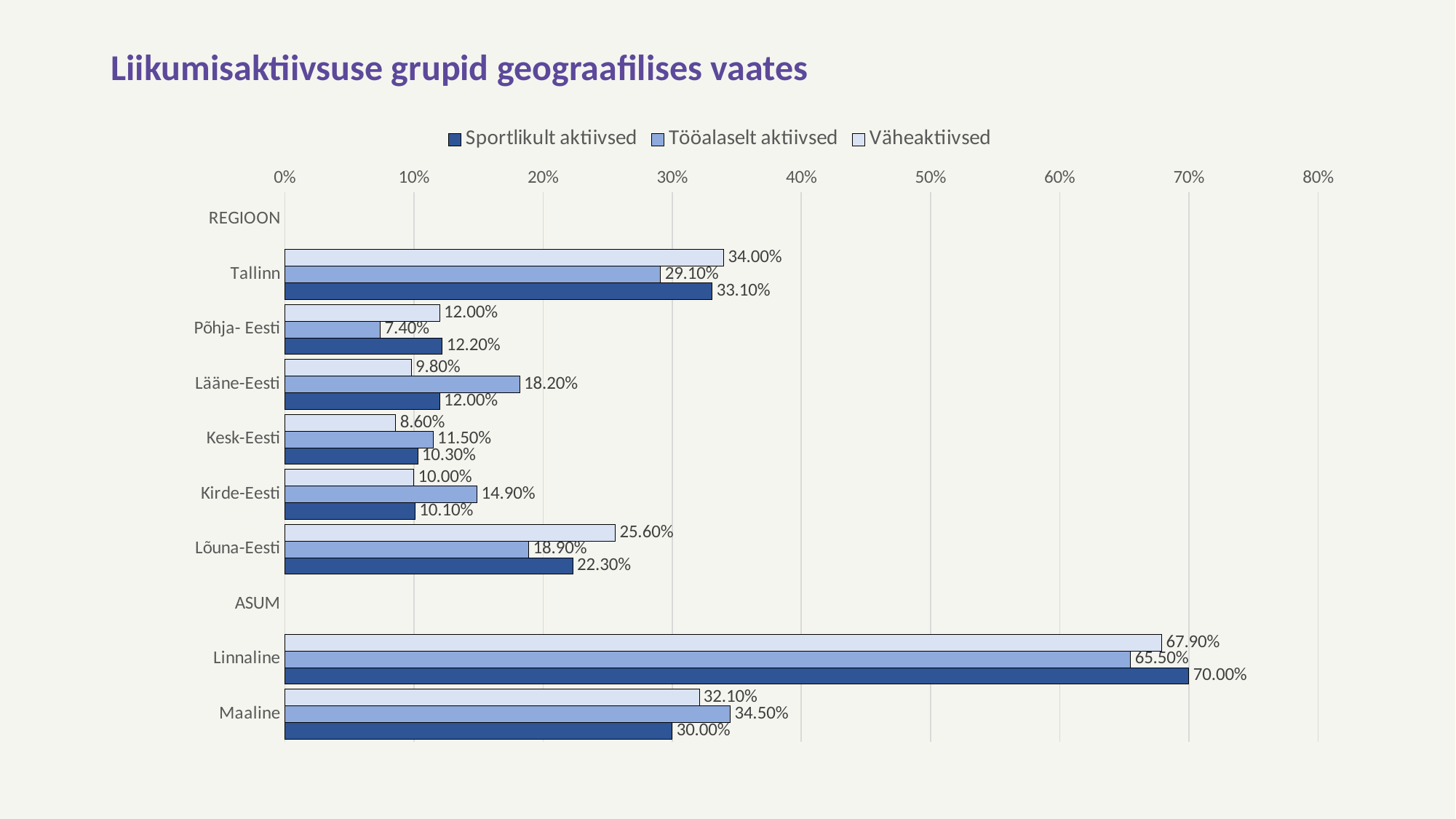
Is the value for Väheaktiivsed in Linnaline greater or less than 60%? greater Which region has the highest value for Tööalaselt aktiivsed among the REGIOON categories? Tallinn What type of chart is shown on the slide? Bar chart How many series does the legend list? 3 What is the value for Sportlikult aktiivsed in Tallinn? 33.10% What is the value for Väheaktiivsed in Lõuna-Eesti? 25.60% What is the title of the chart? Liikumisaktiivsuse grupid geograafilises vaates What is the value for Tööalaselt aktiivsed in Lääne-Eesti? 18.20% Which region has the lowest value for Väheaktiivsed? Kesk-Eesti Which is larger in Kirde-Eesti: Tööalaselt aktiivsed or Sportlikult aktiivsed? Tööalaselt aktiivsed What is the value for Sportlikult aktiivsed in Linnaline? 70.00% What is the difference between the Sportlikult aktiivsed values for Linnaline and Maaline? 40.00%